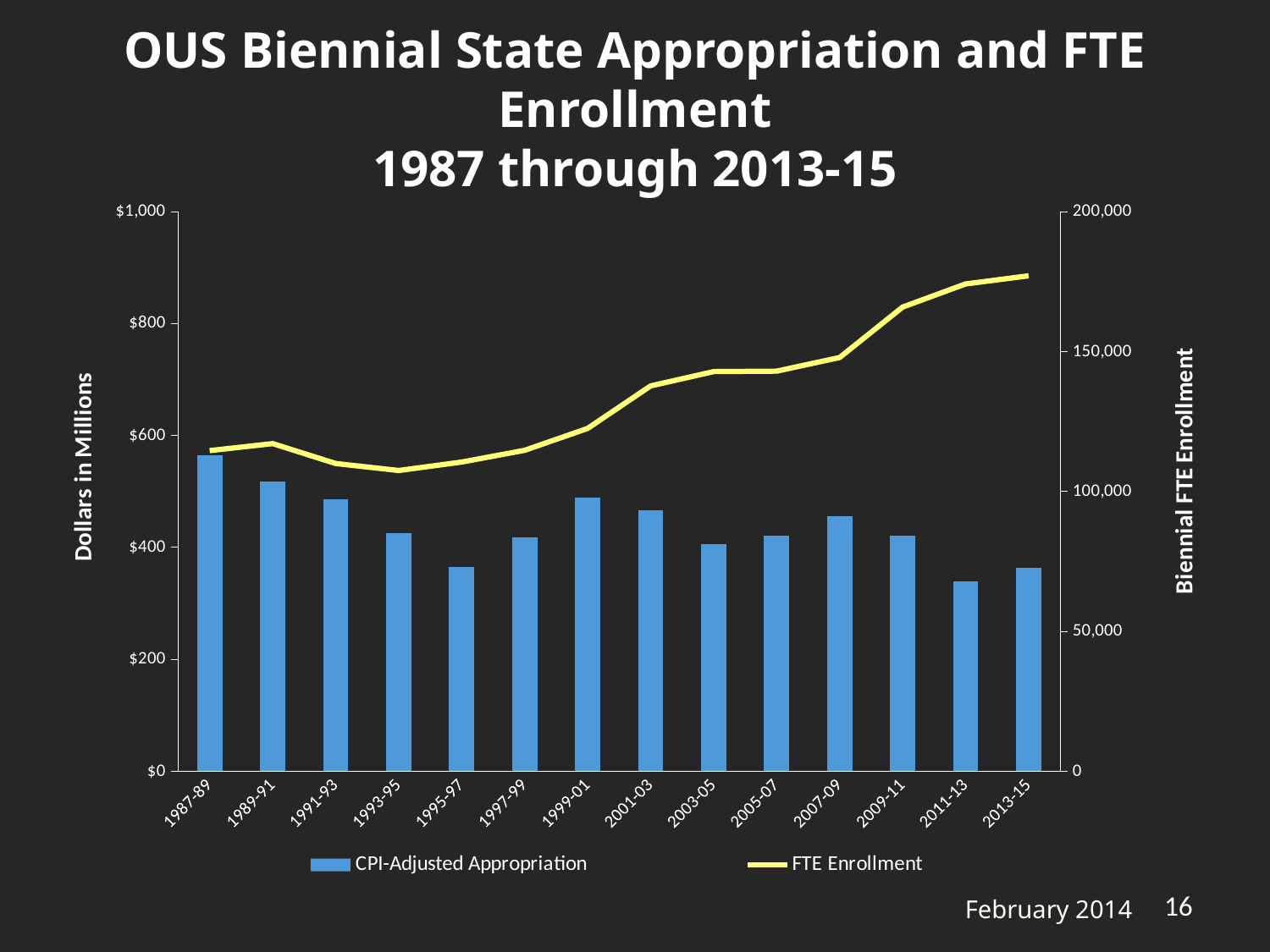
Is the FTE Enrollment for 2013-15 greater or less than 150,000? greater Does FTE Enrollment generally rise or fall from 1987-89 to 2013-15? rise How many biennia (categories) are shown on the x axis? 14 Is the CPI-Adjusted Appropriation for 1987-89 greater or less than $400 million? greater Which has the larger CPI-Adjusted Appropriation, 1999-01 or 1995-97? 1999-01 What is the label of the right-hand vertical axis? Biennial FTE Enrollment Is the CPI-Adjusted Appropriation for 1995-97 greater or less than $400 million? less How many series does the legend list? 2 What kind of chart is shown on the slide? A combination bar and line chart Which biennium has the highest CPI-Adjusted Appropriation? 1987-89 Which biennium has the lowest CPI-Adjusted Appropriation? 2011-13